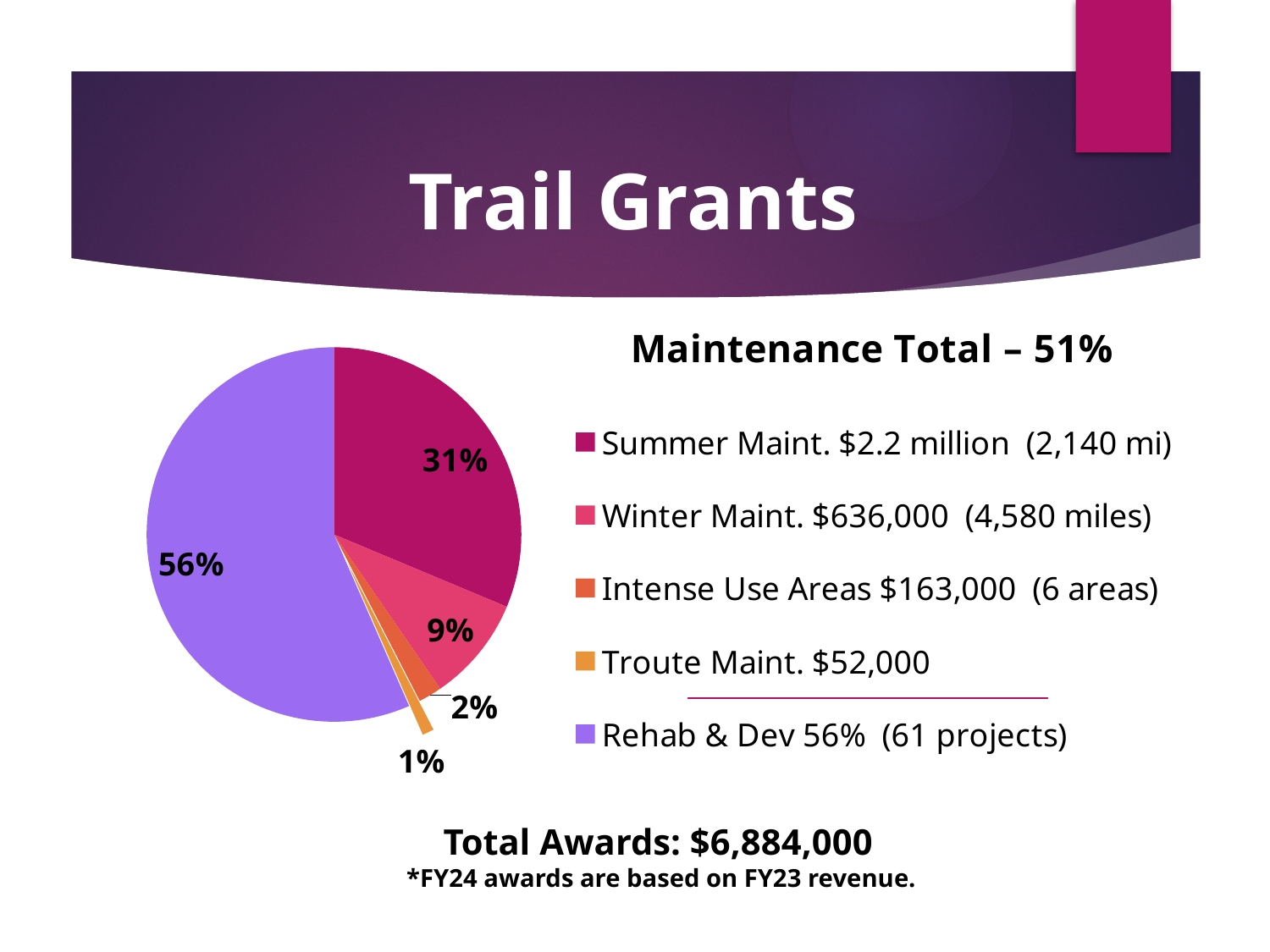
What share of the pie does Troute Maint. represent? 1% What dollar amount does the legend give for Winter Maint.? $636,000 What share of the pie does Intense Use Areas represent? 2% What share of the pie does Rehab & Dev represent? 56% Which slice of the pie is the largest? Rehab & Dev How many slices does the pie chart have? 5 Which slice of the pie is the smallest? Troute Maint. What kind of chart is shown on the slide? pie chart Which is larger, the Winter Maint. slice or the Intense Use Areas slice? Winter Maint. What is the difference in percentage points between the Rehab & Dev slice and the Summer Maint. slice? 25